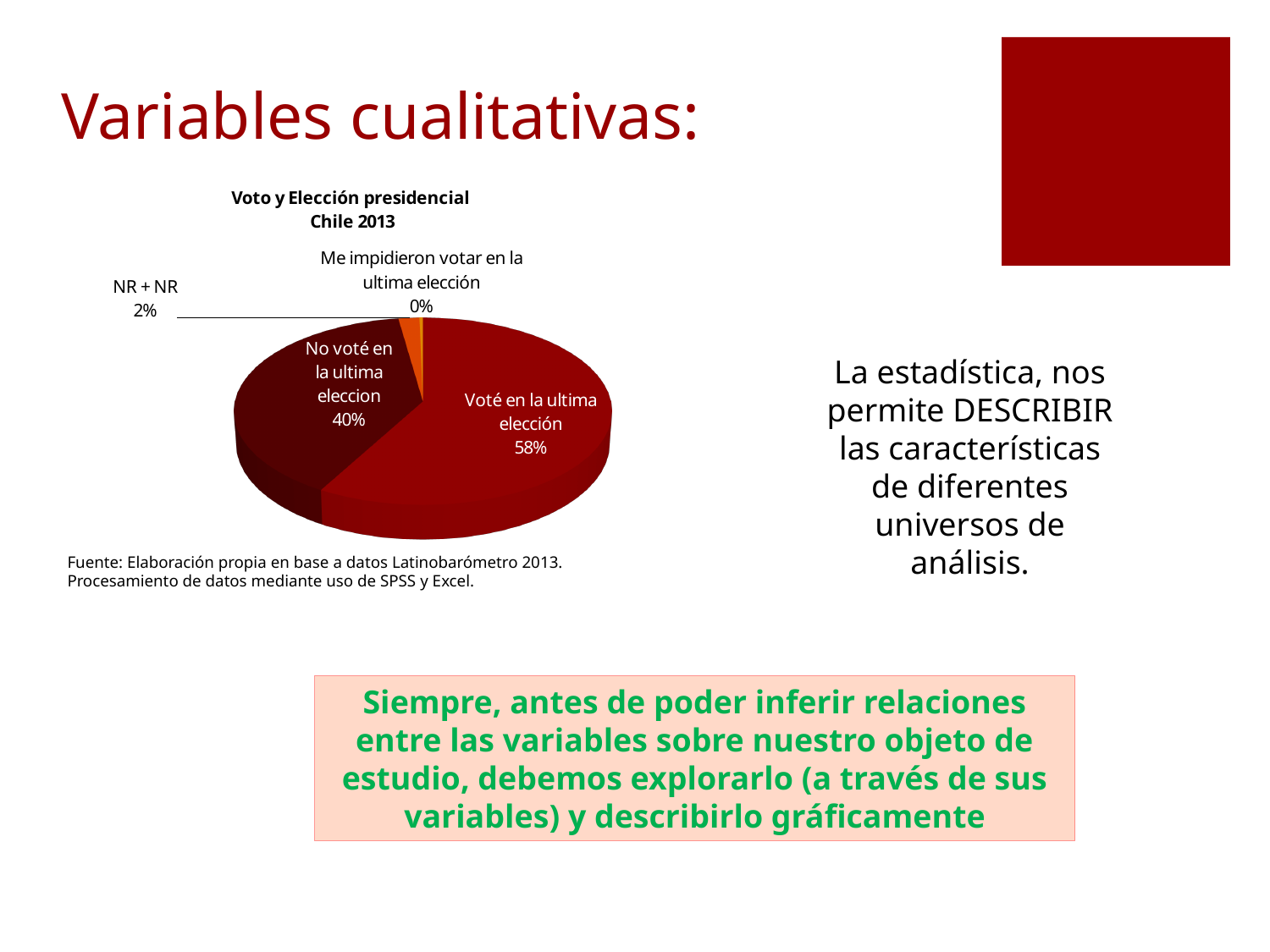
Which category has the smallest share of the pie? Me impidieron votar en la ultima elección Which category has the largest share of the pie? Voté en la ultima elección What percentage is shown for "Voté en la ultima elección"? 58% How many categories (slices) does the pie chart show? 4 What percentage is shown for "NR + NR"? 2% What source is cited below the chart? Latinobarómetro 2013 What is the title of the chart? Voto y Elección presidencial Chile 2013 Which is larger, the share for "No voté en la ultima eleccion" or the share for "NR + NR"? No voté en la ultima eleccion What percentage is shown for "Me impidieron votar en la ultima elección"? 0% What kind of chart is shown on the slide? Pie chart What is the difference in percentage points between "Voté en la ultima elección" and "No voté en la ultima eleccion"? 18 percentage points What percentage is shown for "No voté en la ultima eleccion"? 40%